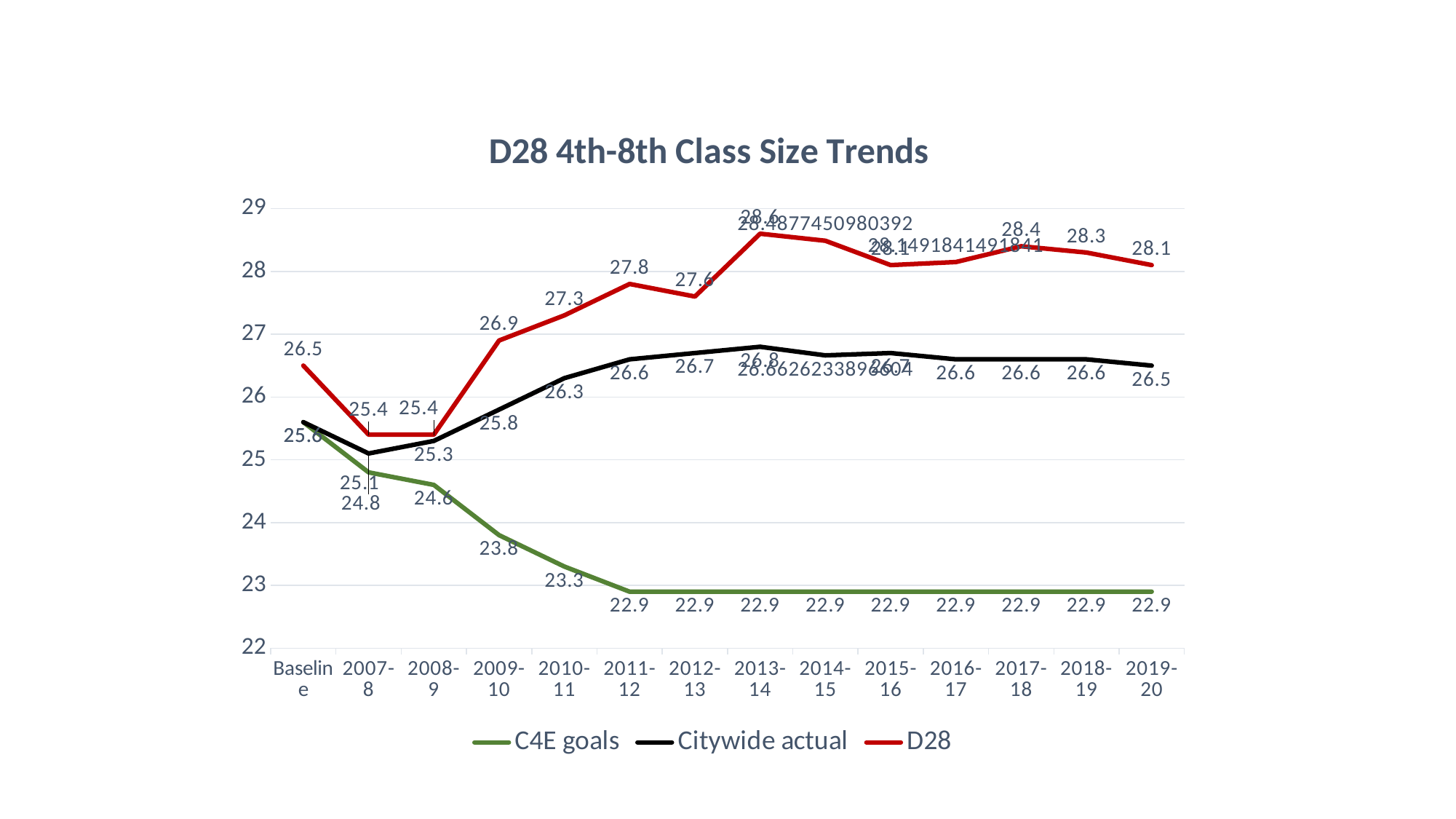
Do the C4E goals values rise or fall from Baseline to 2011-12? Fall How many series does the legend list? 3 What is the D28 value for 2011-12? 27.8 What is the D28 value for 2019-20? 28.1 Is the D28 value for 2014-15 greater or less than 28? greater What kind of chart is this? Line chart What is the difference between the D28 value and the C4E goals value in 2019-20? 5.2 What is the Citywide actual value for 2019-20? 26.5 How many categories are shown on the x axis? 14 What is the Citywide actual value for 2010-11? 26.3 What is the C4E goals value for 2009-10? 23.8 Which is larger in 2019-20, the D28 value or the Citywide actual value? D28